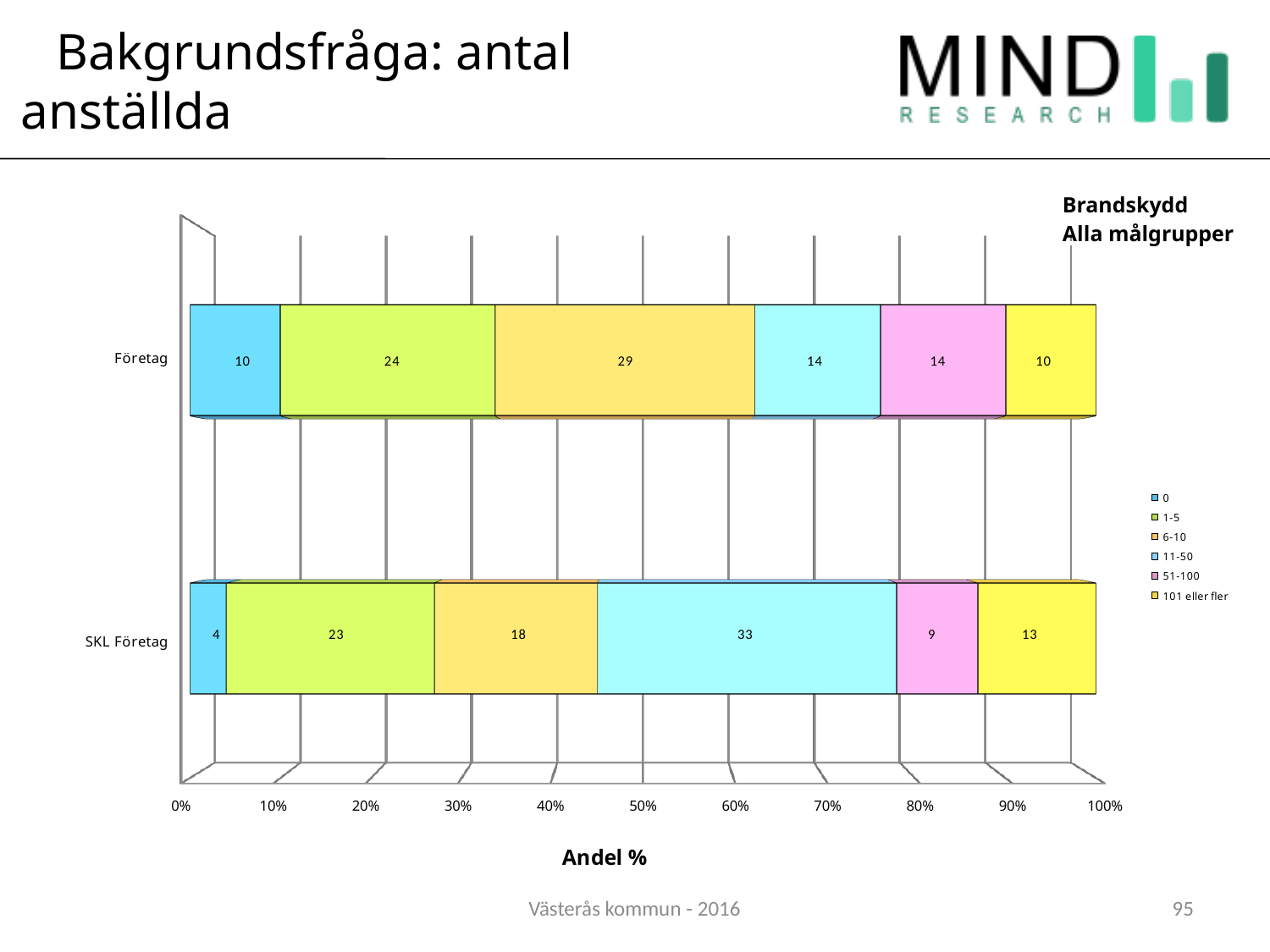
What is the difference between the 11-50 values for SKL Företag and Företag? 19 What is the label of the x axis? Andel % Which series has the largest segment in the Företag bar? 6-10 What is the value of the 101 eller fler segment for Företag? 10 What is the value of the 0 segment for SKL Företag? 4 How many series does the legend list? 6 What is the value of the 6-10 segment for Företag? 29 What kind of chart is shown on the slide? Stacked bar chart How many categories are plotted on the y axis? 2 What is the value of the 11-50 segment for SKL Företag? 33 Which series has the smallest segment in the SKL Företag bar? 0 Which is larger, the 1-5 value for Företag or for SKL Företag? Företag